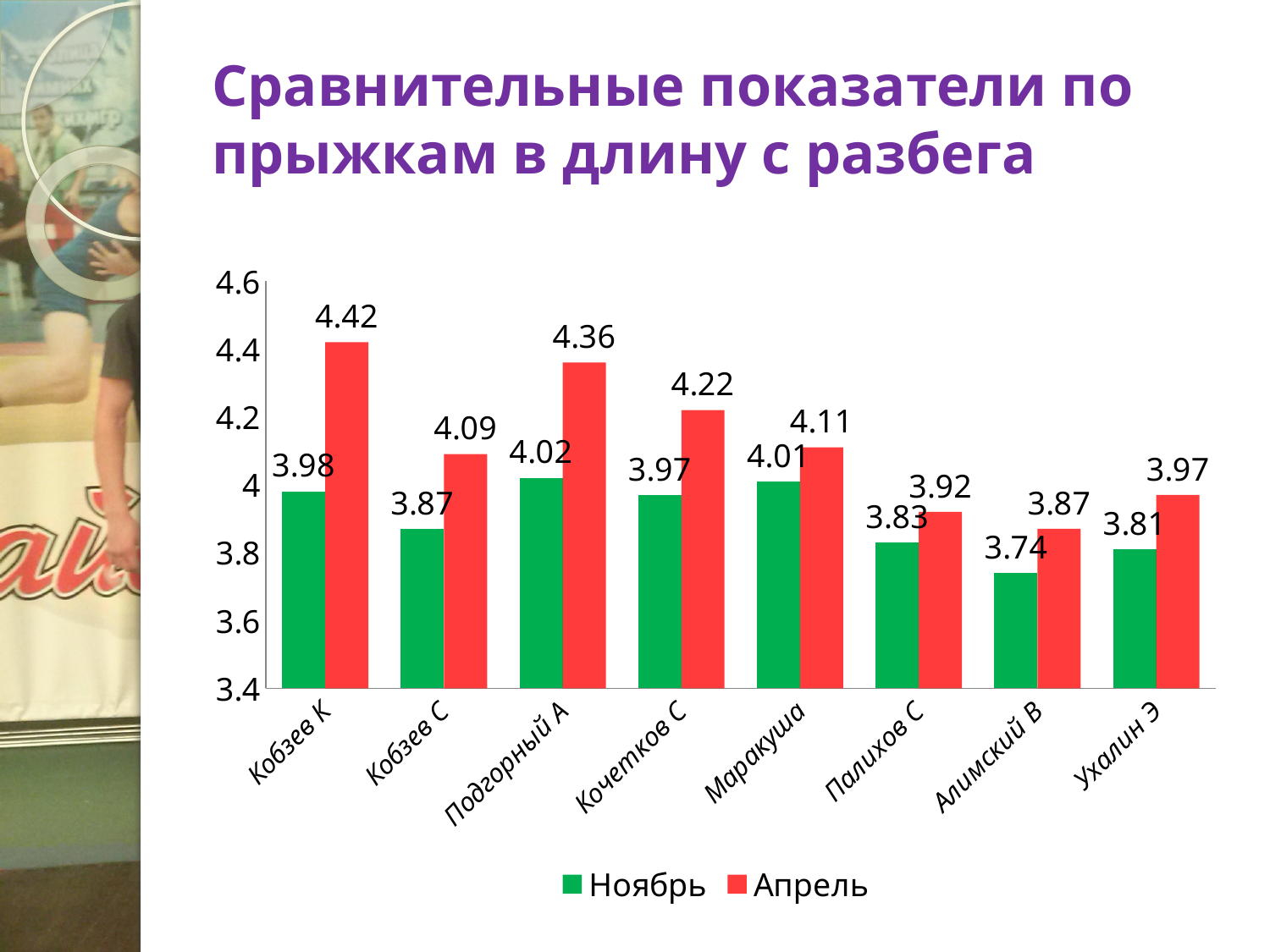
What is the Апрель value for Ухалин Э? 3.97 What kind of chart is shown on the slide? bar chart What is the difference between the Апрель and Ноябрь values for Кобзев К? 0.44 Which is larger: the Ноябрь value for Маракуша or the Ноябрь value for Палихов С? Маракуша Which category has the lowest Ноябрь value? Алимский В What colour are the Апрель bars? red Is the Апрель value for Кочетков С greater or less than 4.2? greater How many series does the legend list? 2 How many categories are shown on the x axis? 8 What is the Апрель value for Подгорный А? 4.36 Which category has the highest Апрель value? Кобзев К What is the Ноябрь value for Кобзев К? 3.98